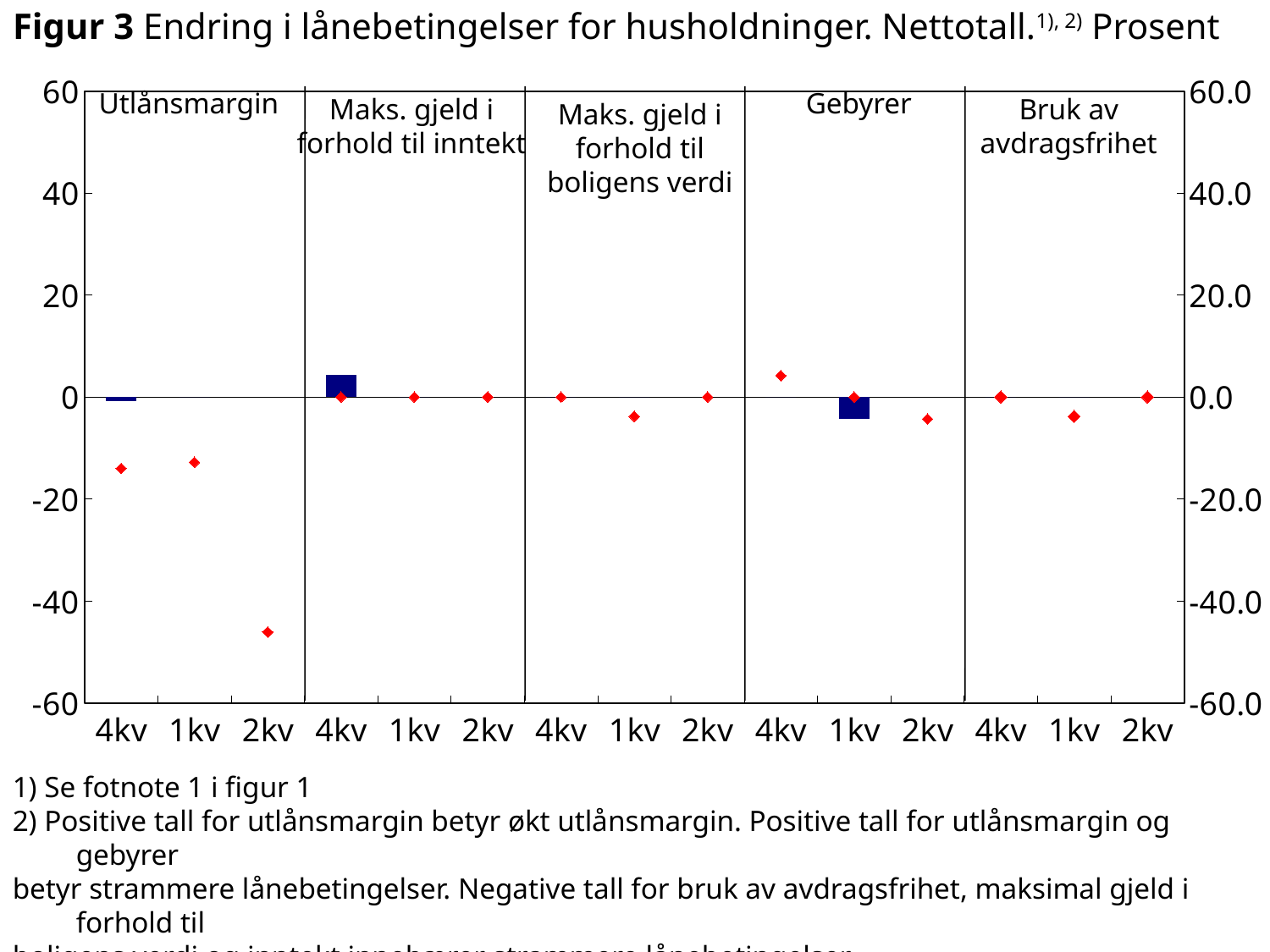
Is the blue bar for 4kv under Maks. gjeld i forhold til inntekt greater or less than 0? greater How many quarters are shown within each panel of the chart? 3 Is the red marker value for 4kv under Utlånsmargin greater or less than -20? greater Is the red marker value for 4kv under Gebyrer greater or less than 0? greater What is the title of the chart? Figur 3 Endring i lånebetingelser for husholdninger. Nettotall. Prosent How many lending-condition panels (categories) does the chart show? 5 What kind of chart is shown in Figur 3? combination bar and line chart (blue bars with red diamond markers) Which quarter in which panel has the lowest value on the chart? 2kv under Utlånsmargin What are the minimum and maximum values shown on the left vertical axis? -60 and 60 Under Utlånsmargin, which is larger: the value for 1kv or the value for 2kv? 1kv